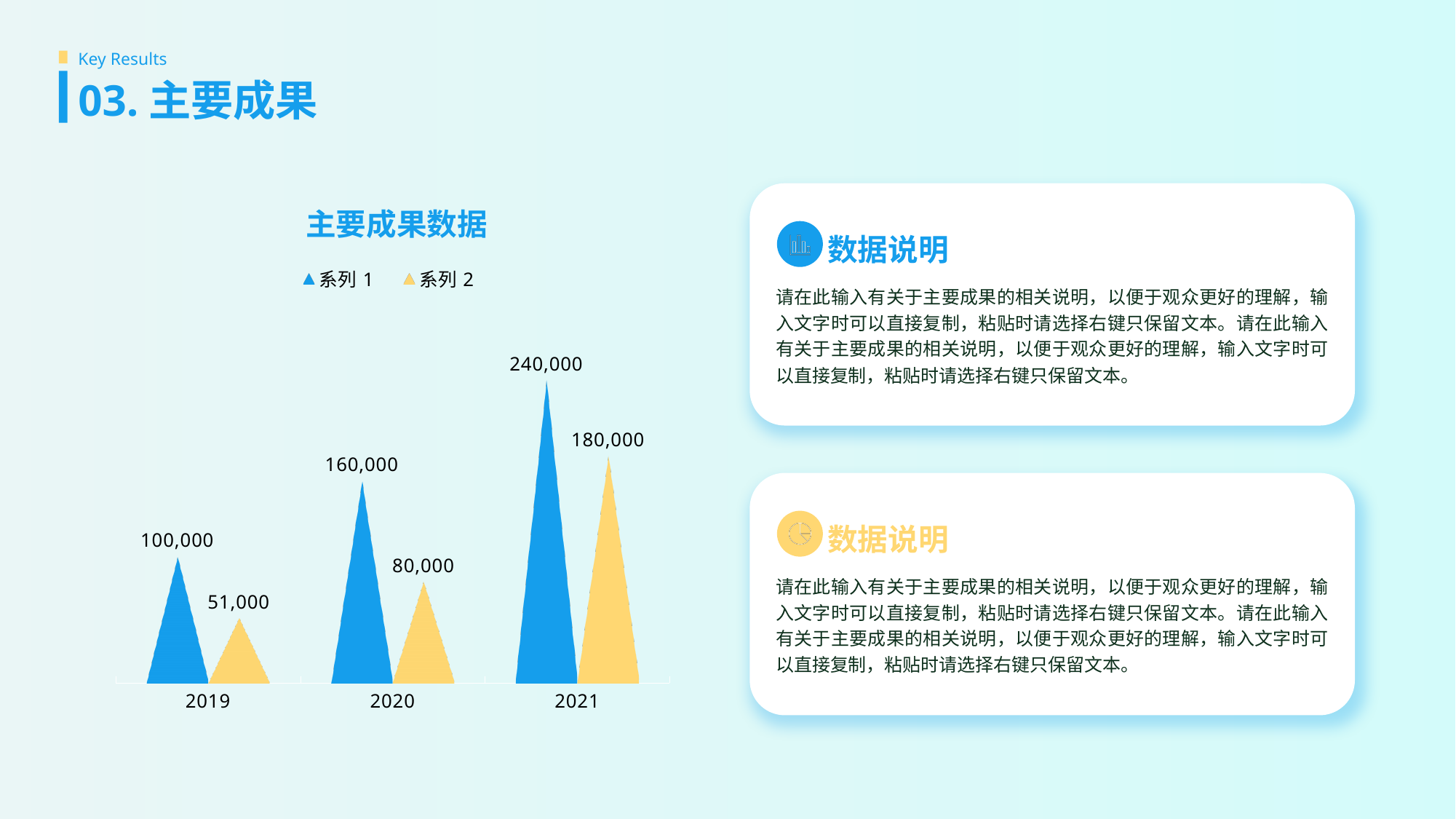
What is the value of 系列 2 for 2020? 80,000 Which year has the highest value for 系列 1? 2021 How many series does the legend list? 2 What is the title of the chart? 主要成果数据 Which year has the lowest value for 系列 2? 2019 Which is larger in 2020, 系列 1 or 系列 2? 系列 1 What is the difference between the 系列 1 values for 2020 and 2019? 60,000 What is the value of 系列 1 for 2019? 100,000 What is the value of 系列 2 for 2021? 180,000 How many years are shown on the x axis? 3 Do the 系列 2 values rise or fall from 2019 to 2021? rise What is the difference between 系列 1 and 系列 2 in 2021? 60,000